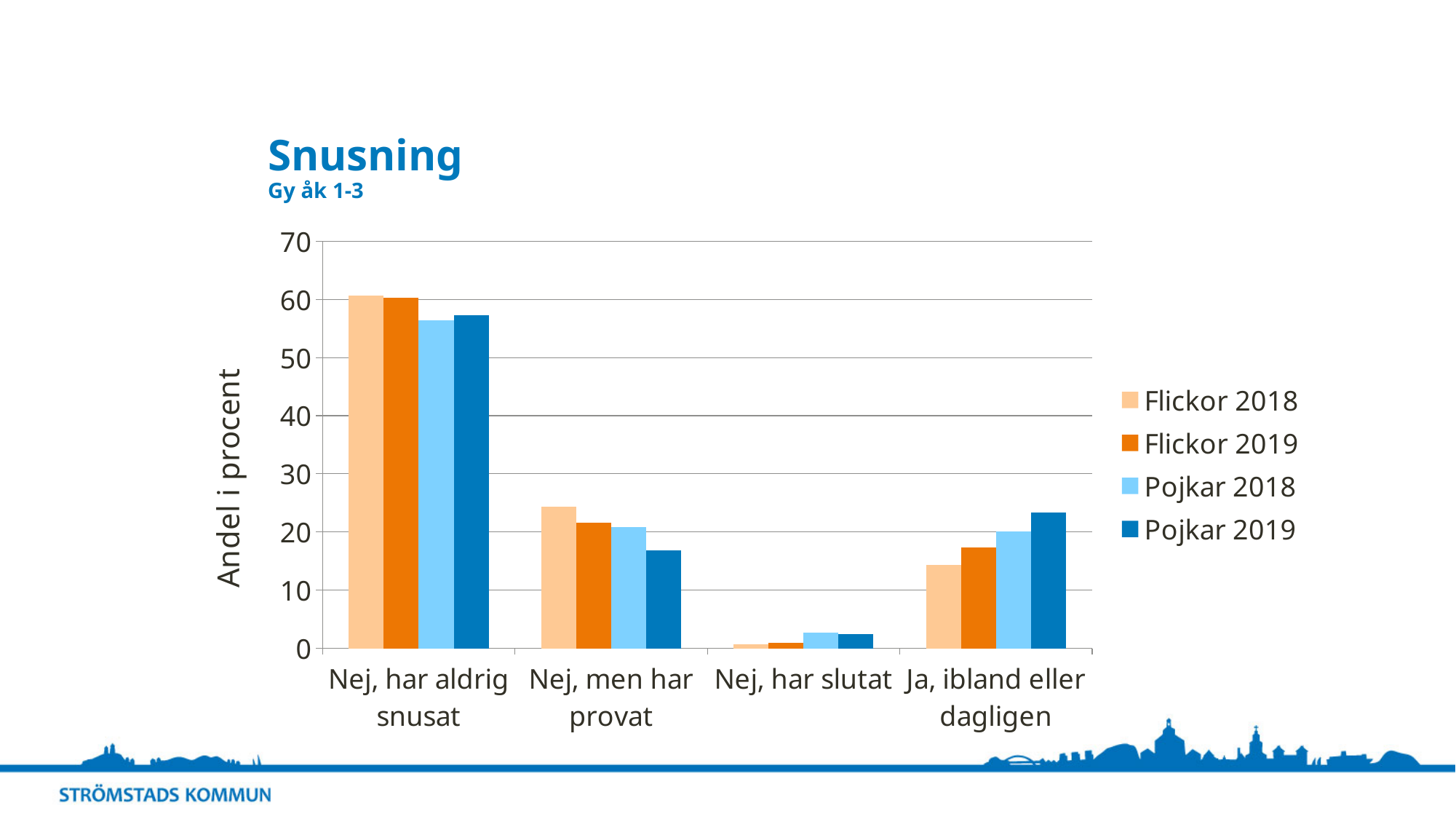
What kind of chart is shown on the slide? bar chart How many categories are shown on the x axis of the chart? 4 Is the value for Flickor 2018 in the category "Nej, har aldrig snusat" greater or less than 50? greater Which category has the lowest value for Flickor 2018? Nej, har slutat What is the label on the y axis of the chart? Andel i procent Is the value for Pojkar 2019 in the category "Nej, men har provat" greater or less than 20? less Is the value for Pojkar 2019 in the category "Ja, ibland eller dagligen" greater or less than 20? greater In the category "Ja, ibland eller dagligen", which series has the highest bar? Pojkar 2019 In the category "Nej, men har provat", which is larger: Flickor 2018 or Pojkar 2019? Flickor 2018 Which category has the highest value for Pojkar 2019? Nej, har aldrig snusat In the category "Ja, ibland eller dagligen", which is larger: Flickor 2018 or Pojkar 2019? Pojkar 2019 How many series does the legend list? 4